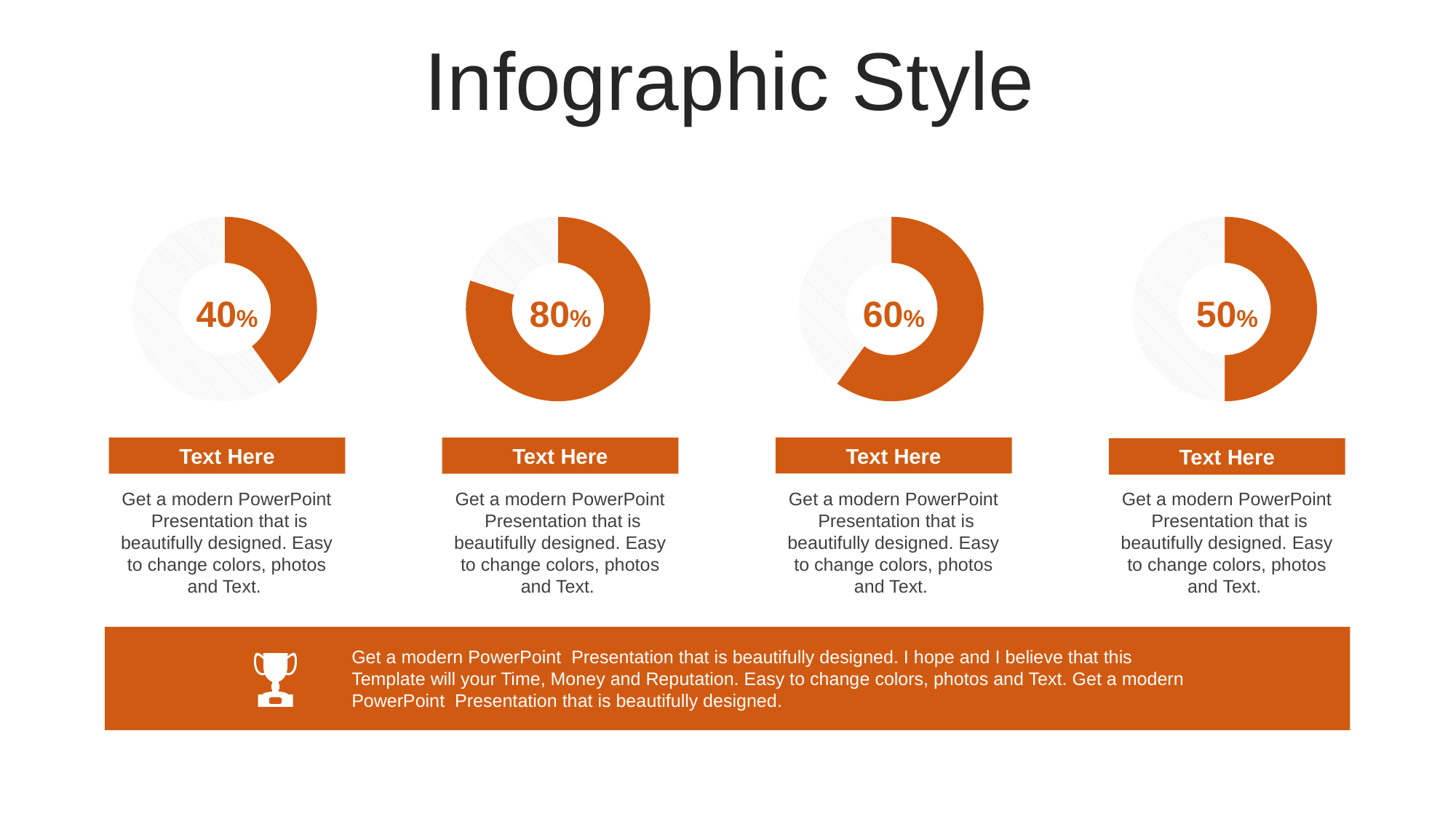
What value is shown in the centre of the third donut chart from the left? 60% What value is shown in the centre of the leftmost donut chart? 40% Which donut chart on the slide shows the lowest percentage? The leftmost (40%) Which is larger: the value in the third donut chart or the value in the rightmost donut chart? The third donut chart (60%) What kind of chart is used for each of the four percentage figures on the slide? Donut chart What is the difference between the value in the third donut chart (60%) and the value in the rightmost donut chart (50%)? 10% What value is shown in the centre of the rightmost donut chart? 50% Which donut chart on the slide shows the highest percentage? The second from the left (80%) What value is shown in the centre of the second donut chart from the left? 80% What colour is the filled portion of each donut chart? Orange How many donut charts are shown on the slide? 4 What is the difference between the value in the second donut chart (80%) and the value in the leftmost donut chart (40%)? 40%